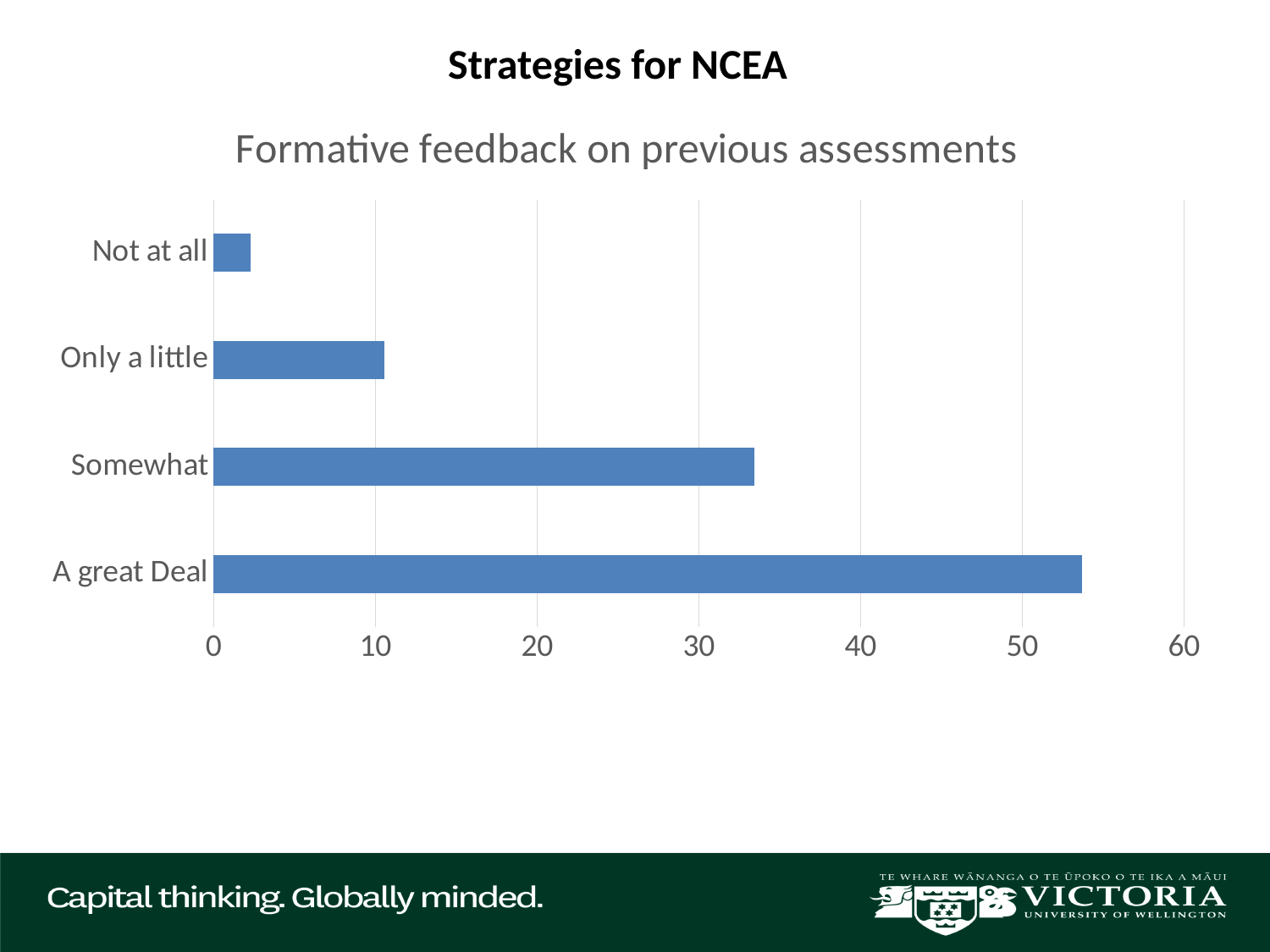
What is the title of the chart? Formative feedback on previous assessments Which category has the highest value? A great Deal Which is larger, the value for Somewhat or the value for Only a little? Somewhat Is the value for A great Deal greater or less than 50? greater Is the value for Not at all greater or less than 10? less Is the value for Only a little greater or less than 20? less How many categories are plotted in the chart? 4 What is the maximum value shown on the horizontal axis? 60 Which category has the lowest value? Not at all Which is larger, the value for Not at all or the value for A great Deal? A great Deal What kind of chart is shown on the slide? bar chart